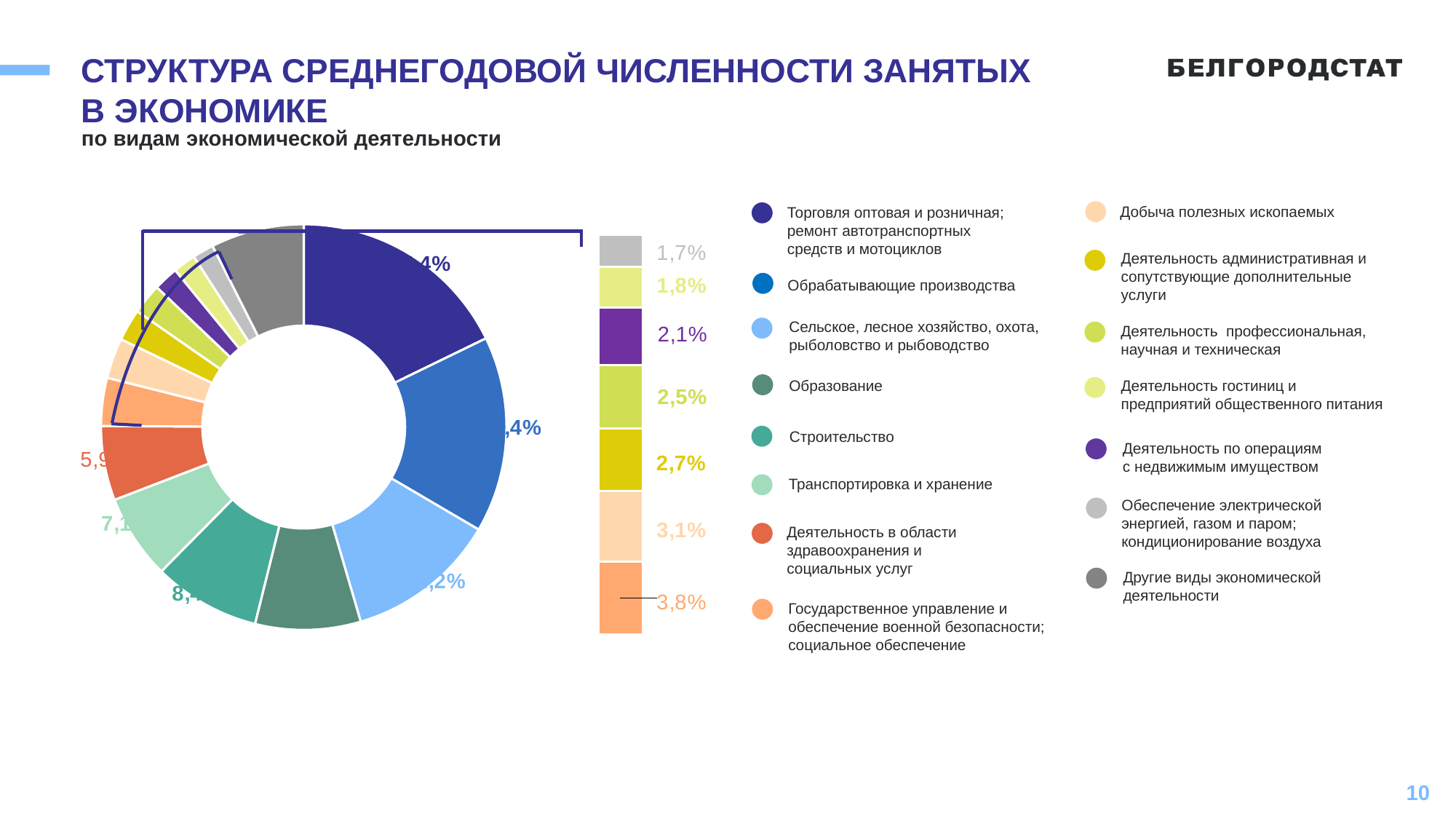
What share is shown for «Добыча полезных ископаемых»? 3,1% What kind of chart is shown on the slide? doughnut chart Which has the larger share: «Добыча полезных ископаемых» or «Деятельность административная и сопутствующие дополнительные услуги»? Добыча полезных ископаемых Which category has the largest slice of the pie? Торговля оптовая и розничная; ремонт автотранспортных средств и мотоциклов How many categories are listed in the legend? 15 What share is shown for «Деятельность административная и сопутствующие дополнительные услуги»? 2,7% What share is shown for «Деятельность по операциям с недвижимым имуществом»? 2,1% What share is shown for «Деятельность гостиниц и предприятий общественного питания»? 1,8% What share is shown for «Государственное управление и обеспечение военной безопасности; социальное обеспечение»? 3,8% What share is shown for «Деятельность профессиональная, научная и техническая»? 2,5% By how many percentage points does the share of «Государственное управление и обеспечение военной безопасности; социальное обеспечение» exceed that of «Обеспечение электрической энергией, газом и паром; кондиционирование воздуха»? 2,1 What share is shown for «Обеспечение электрической энергией, газом и паром; кондиционирование воздуха»? 1,7%